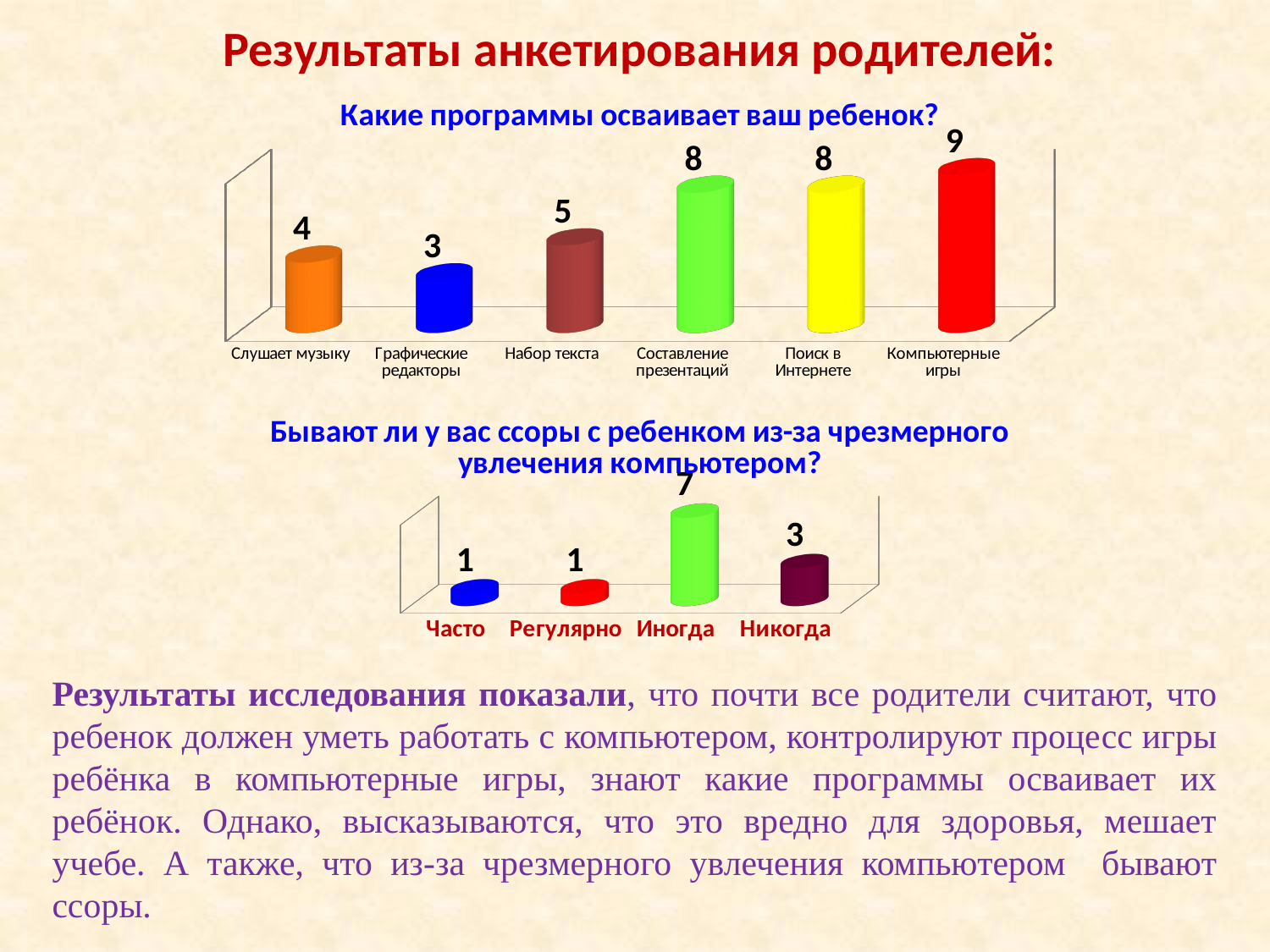
In the chart 'Бывают ли у вас ссоры с ребенком из-за чрезмерного увлечения компьютером?', what is the difference between 'Иногда' and 'Никогда'? 4 What type of chart is the bottom chart on the slide? Bar chart In the chart 'Какие программы осваивает ваш ребенок?', which category has the lowest value? Графические редакторы In the chart 'Какие программы осваивает ваш ребенок?', which category has the highest value? Компьютерные игры In the chart 'Какие программы осваивает ваш ребенок?', what is the difference between 'Компьютерные игры' and 'Графические редакторы'? 6 In the chart 'Бывают ли у вас ссоры с ребенком из-за чрезмерного увлечения компьютером?', what is the value for 'Иногда'? 7 In the chart 'Какие программы осваивает ваш ребенок?', which is larger: 'Набор текста' or 'Поиск в Интернете'? Поиск в Интернете How many categories are shown in the chart 'Бывают ли у вас ссоры с ребенком из-за чрезмерного увлечения компьютером?'? 4 In the chart 'Бывают ли у вас ссоры с ребенком из-за чрезмерного увлечения компьютером?', which category has the highest value? Иногда How many categories are shown in the chart 'Какие программы осваивает ваш ребенок?'? 6 In the chart 'Какие программы осваивает ваш ребенок?', what is the value for 'Составление презентаций'? 8 In the chart 'Какие программы осваивает ваш ребенок?', what is the value for 'Слушает музыку'? 4